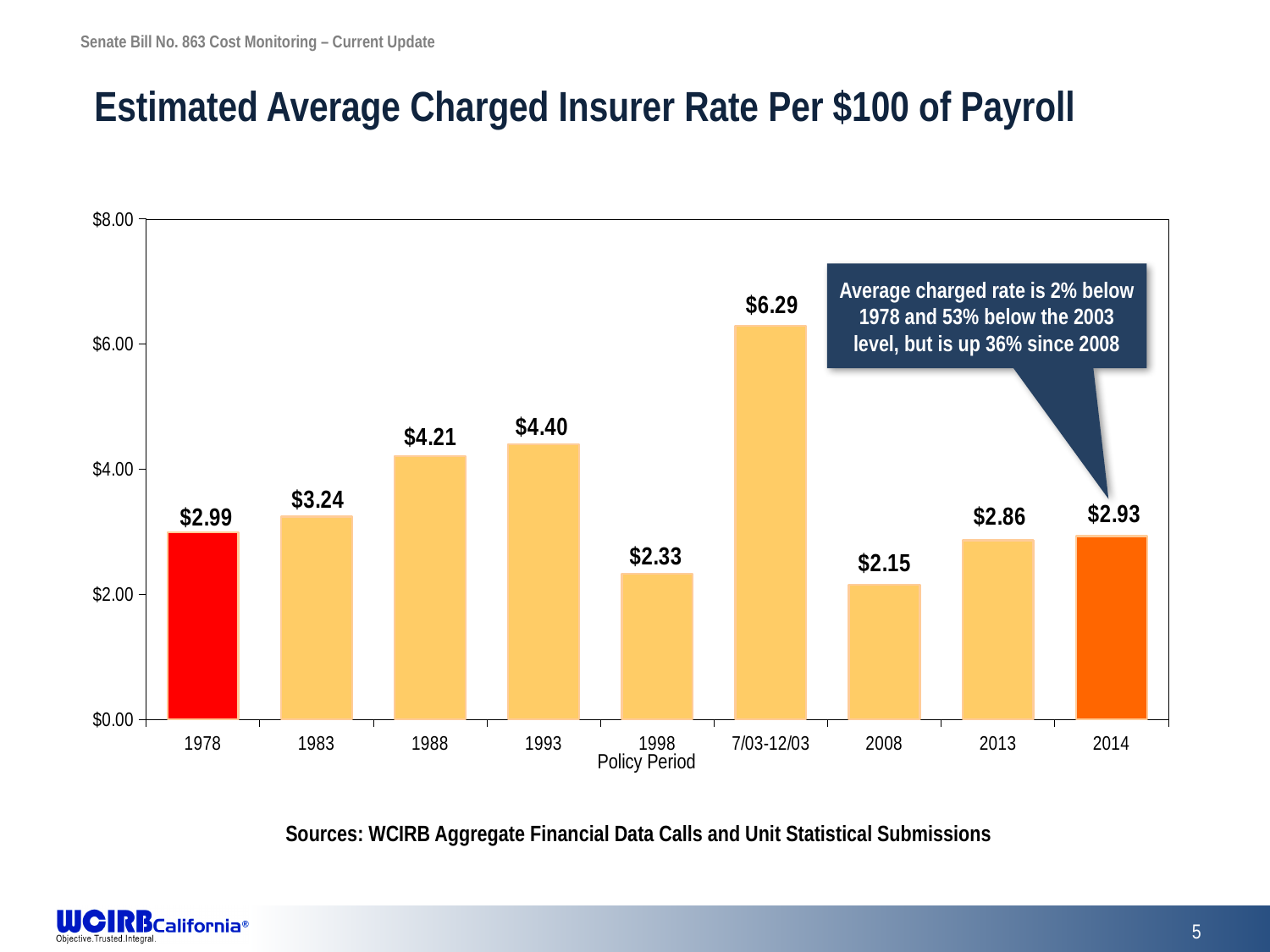
What is the label of the x axis? Policy Period Which policy period has the highest charged rate? 7/03-12/03 Is the value for 1998 greater or less than $4.00? less What is the value shown for the 7/03-12/03 policy period? $6.29 How many policy periods are shown on the x axis? 9 What is the estimated average charged insurer rate per $100 of payroll for 1978? $2.99 Do the values rise or fall from 2008 to 2014? rise Which policy period has the lowest charged rate? 2008 What is the difference between the 2014 value and the 2008 value? $0.78 What is the value shown for 2014? $2.93 Which is larger, the value for 1993 or the value for 1988? 1993 What kind of chart is shown on the slide? bar chart